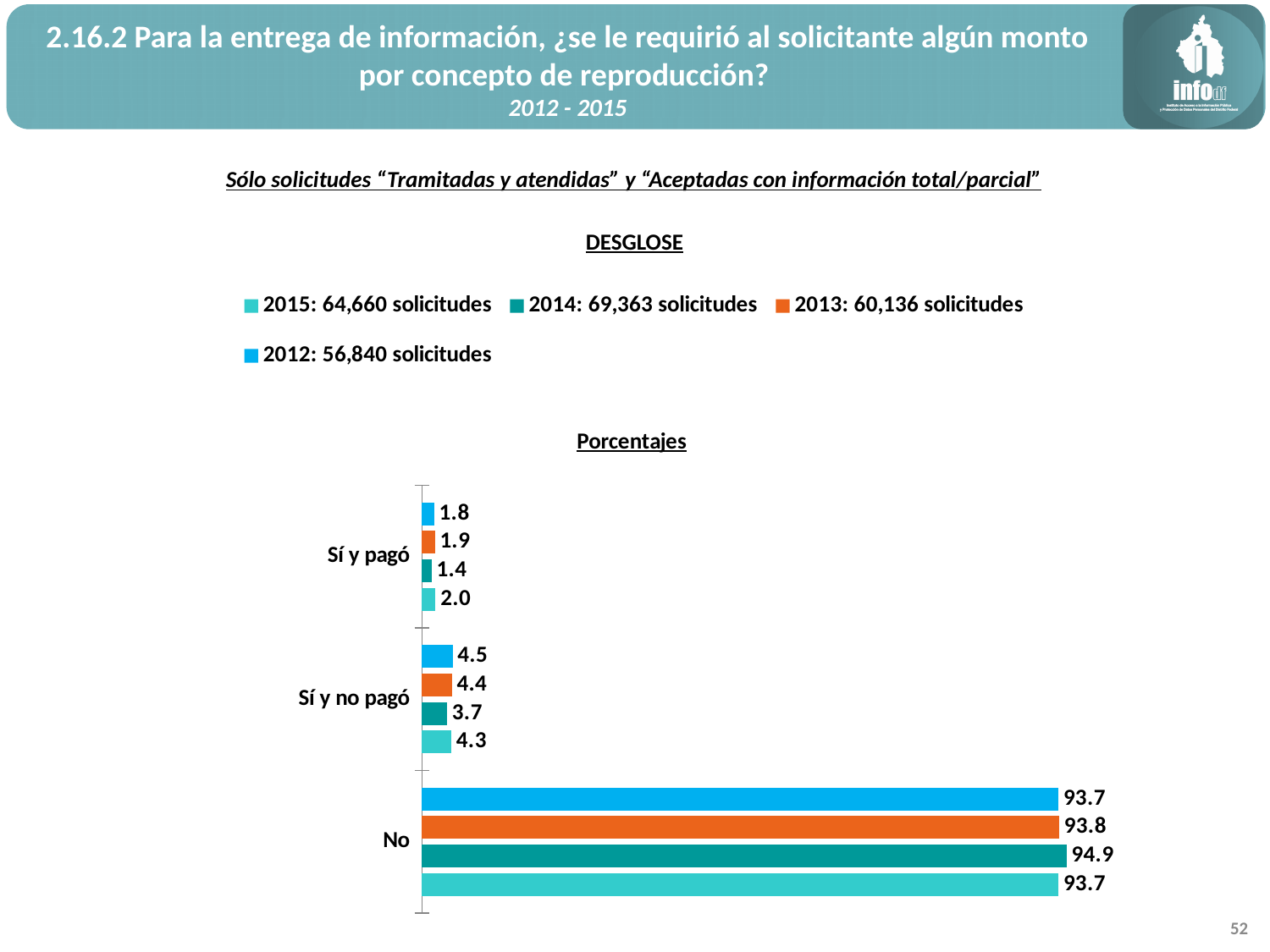
How many series does the legend list? 4 What is the value for 2015 in the "Sí y pagó" category? 2.0 What is the difference between the 2012 and 2014 values in the "Sí y no pagó" category? 0.8 Which is larger in the "Sí y pagó" category: the value for 2015 or the value for 2014? 2015 Which year has the lowest value in the "Sí y no pagó" category? 2014 According to the legend, how many solicitudes were there in 2014? 69,363 solicitudes What is the value for 2012 in the "Sí y no pagó" category? 4.5 How many categories are shown on the chart? 3 What is the value for 2013 in the "Sí y pagó" category? 1.9 What kind of chart is shown on the slide? Bar chart What is the value for 2014 in the "No" category? 94.9 Which year has the highest value in the "No" category? 2014